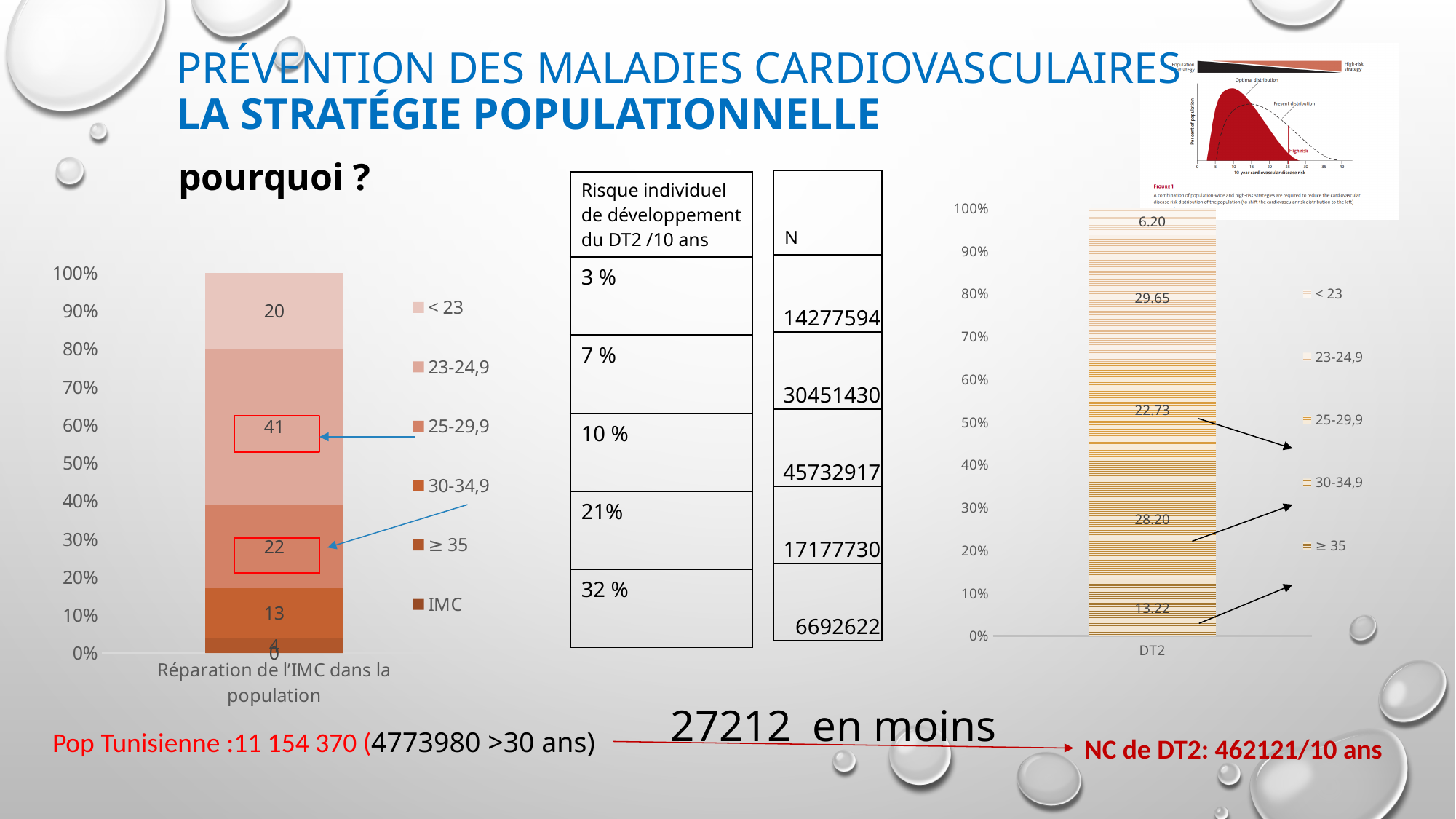
In the right chart (DT2), what is the total of all the labelled segments of the bar? 100.00 In the left chart 'Réparation de l'IMC dans la population', what is the largest segment value shown on the bar? 41 In the right chart (DT2), what is the smallest segment value shown on the bar? 6.20 In the right chart (DT2), what is the difference between the segment labelled 29.65 and the segment labelled 28.20? 1.45 In the left chart, what is the difference between the segment labelled 41 and the segment labelled 22? 19 How many entries does the legend of the left chart 'Réparation de l'IMC dans la population' list? 6 What is the category label on the x axis of the right chart? DT2 In the left chart, which is larger: the segment labelled 13 or the segment labelled 22? 22 What kind of chart is the left chart titled 'Réparation de l'IMC dans la population'? Stacked bar chart In the right chart (DT2), what is the largest segment value shown on the bar? 29.65 How many entries does the legend of the right chart (DT2) list? 5 In the left chart 'Réparation de l'IMC dans la population', what value is labelled on the topmost segment of the bar? 20